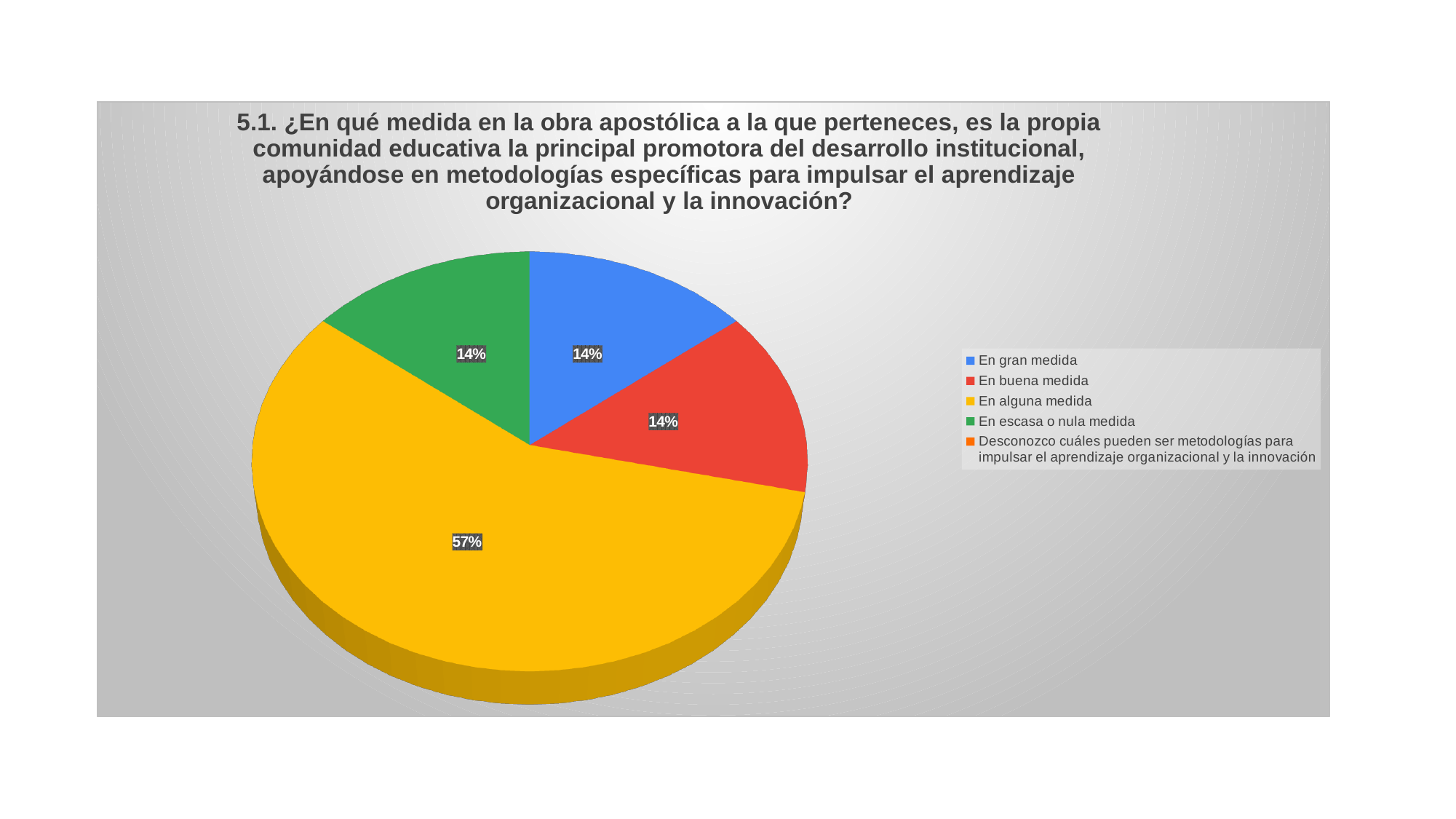
What is the difference between the share for "En alguna medida" and the share for "En gran medida"? 43% Which legend entry is shown in blue? En gran medida Which category has the largest slice of the pie? En alguna medida What colour is the slice for "En alguna medida"? yellow What share of the pie does "En alguna medida" represent? 57% How many entries does the legend list? 5 What share of the pie does "En buena medida" represent? 14% Which is larger, the share for "En alguna medida" or the share for "En escasa o nula medida"? En alguna medida What kind of chart is shown on the slide? pie chart What share of the pie does "En escasa o nula medida" represent? 14% How many slices with a printed percentage are visible in the pie? 4